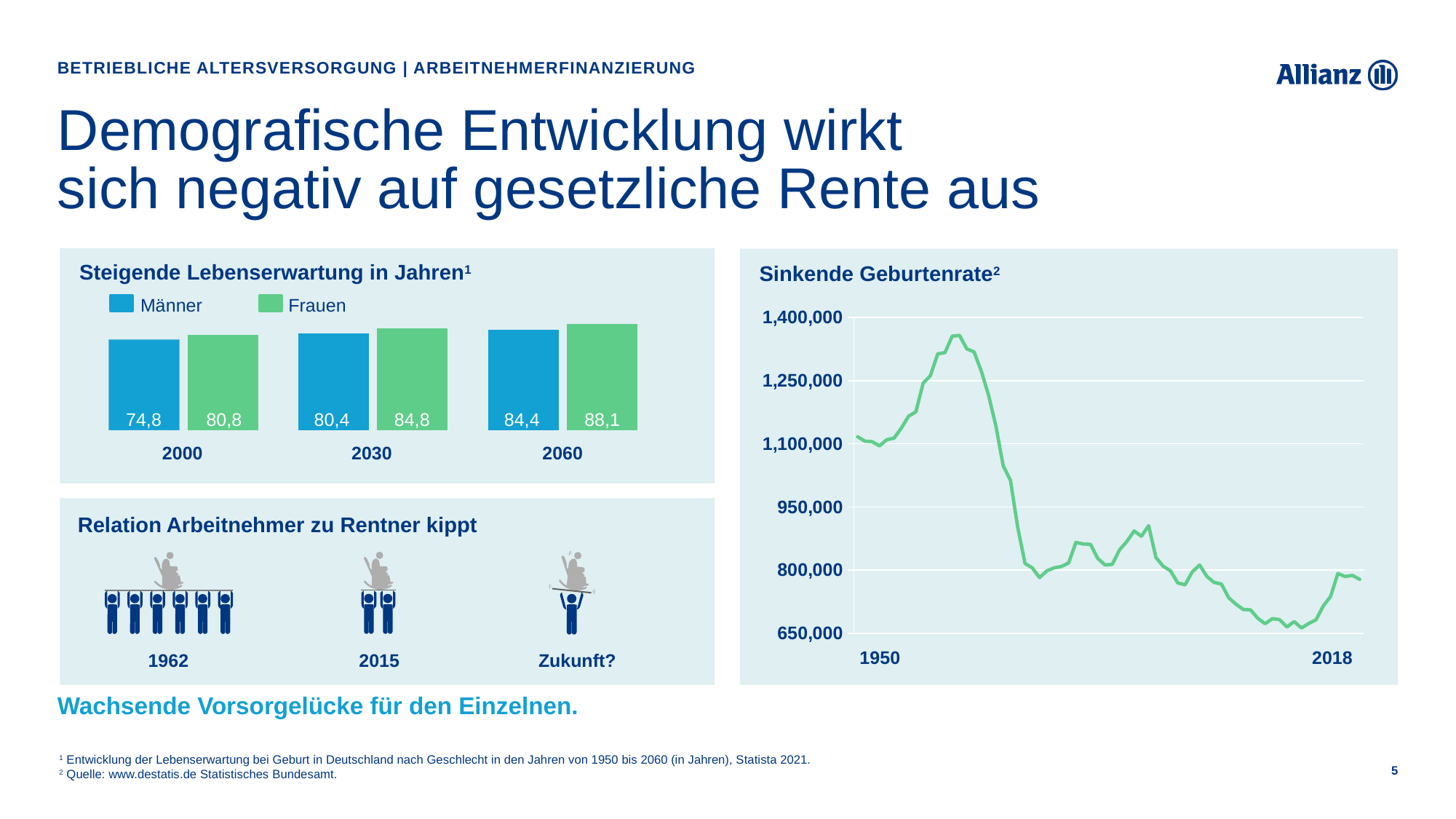
In the chart 'Steigende Lebenserwartung in Jahren', what is the difference between Frauen and Männer in 2000? 6,0 What kind of chart is 'Sinkende Geburtenrate'? Line chart In the chart 'Sinkende Geburtenrate', do the values overall rise or fall from 1950 to 2018? fall In the chart 'Steigende Lebenserwartung in Jahren', which year has the highest value for Männer? 2060 In the chart 'Steigende Lebenserwartung in Jahren', what is the value for Männer in 2000? 74,8 What kind of chart is 'Steigende Lebenserwartung in Jahren'? Bar chart In the chart 'Steigende Lebenserwartung in Jahren', what is the value for Frauen in 2030? 84,8 In the chart 'Sinkende Geburtenrate', is the peak value greater or less than 1,250,000? greater In the chart 'Steigende Lebenserwartung in Jahren', by how much does the Männer value increase from 2000 to 2060? 9,6 In the chart 'Steigende Lebenserwartung in Jahren', which is larger: Männer in 2060 or Frauen in 2030? Frauen in 2030 In the chart 'Steigende Lebenserwartung in Jahren', what is the value for Frauen in 2060? 88,1 How many series does the legend of the chart 'Steigende Lebenserwartung in Jahren' list? 2